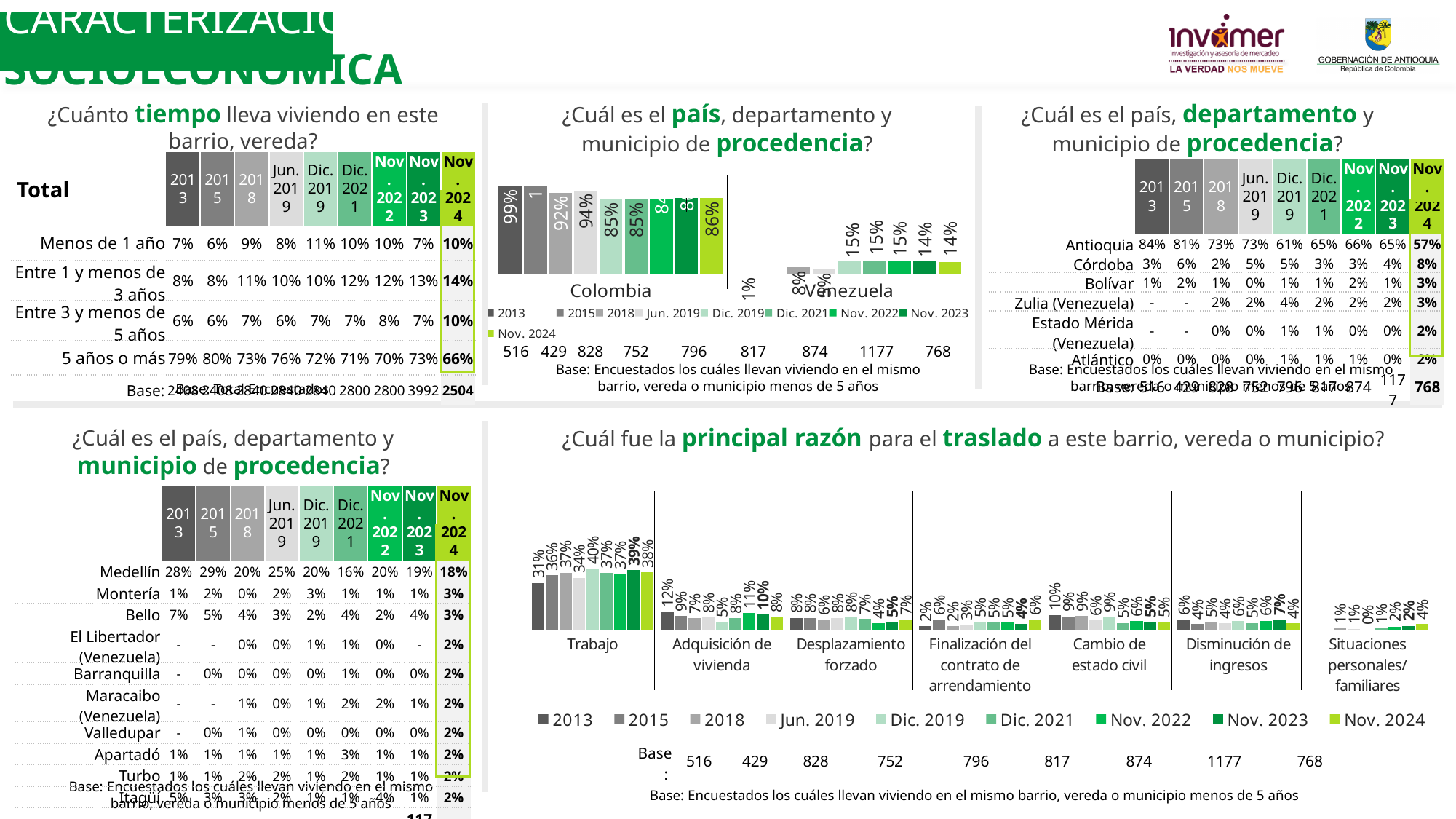
In the top-middle chart '¿Cuál es el país, departamento y municipio de procedencia?', what is the 2013 value for Colombia? 99% In the chart '¿Cuál fue la principal razón para el traslado a este barrio, vereda o municipio?', what is the Nov. 2024 value for Trabajo? 38% In the chart '¿Cuál fue la principal razón para el traslado a este barrio, vereda o municipio?', what is the 2013 value for Cambio de estado civil? 10% In the chart '¿Cuál fue la principal razón para el traslado a este barrio, vereda o municipio?', how many series does the legend list? 9 In the chart '¿Cuál fue la principal razón para el traslado a este barrio, vereda o municipio?', how many reason categories are shown on the x axis? 7 In the chart '¿Cuál fue la principal razón para el traslado a este barrio, vereda o municipio?', what kind of chart is shown? Bar chart In the chart '¿Cuál fue la principal razón para el traslado a este barrio, vereda o municipio?', which category has the highest Nov. 2024 value? Trabajo In the top-middle chart '¿Cuál es el país, departamento y municipio de procedencia?', how many countries are shown on the x axis? 2 In the chart '¿Cuál fue la principal razón para el traslado a este barrio, vereda o municipio?', what is the difference between the Trabajo values for Dic. 2019 and 2013? 9 percentage points In the chart '¿Cuál fue la principal razón para el traslado a este barrio, vereda o municipio?', which is larger for Nov. 2022: Adquisición de vivienda or Desplazamiento forzado? Adquisición de vivienda In the top-middle chart '¿Cuál es el país, departamento y municipio de procedencia?', what is the Nov. 2024 value for Venezuela? 14% In the chart '¿Cuál fue la principal razón para el traslado a este barrio, vereda o municipio?', which series has the highest value for Trabajo? Dic. 2019